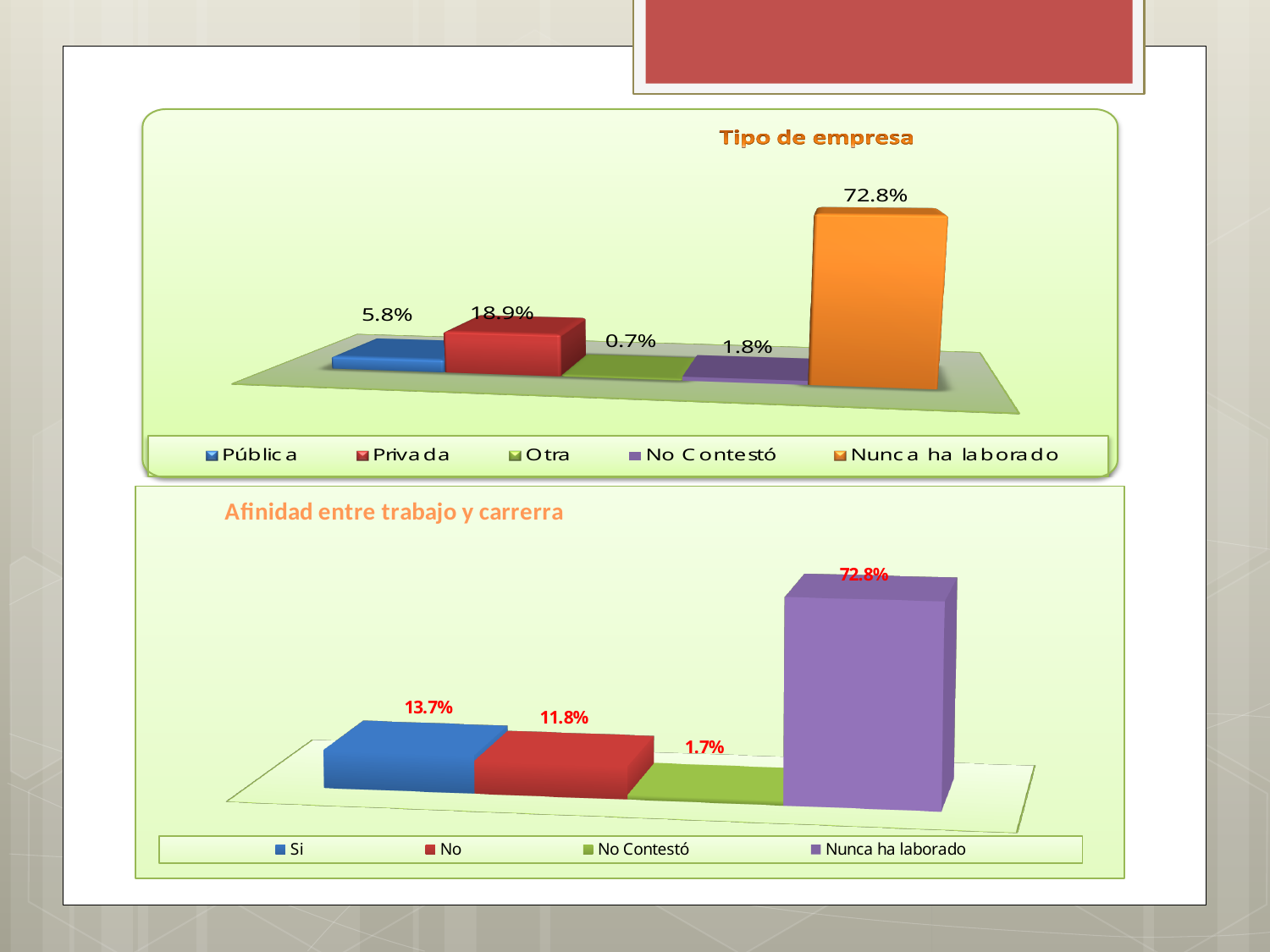
In the 'Tipo de empresa' chart, what is the value for Privada? 18.9% In the 'Afinidad entre trabajo y carrerra' chart, which is larger, Si or No? Si In the 'Afinidad entre trabajo y carrerra' chart, what is the difference between Si and No? 1.9% In the 'Afinidad entre trabajo y carrerra' chart, what colour is the bar for Nunca ha laborado? Purple In the 'Tipo de empresa' chart, what is the difference between Nunca ha laborado and Privada? 53.9% In the 'Afinidad entre trabajo y carrerra' chart, what is the value for No Contestó? 1.7% What kind of chart is the 'Afinidad entre trabajo y carrerra' chart? Bar chart In the 'Afinidad entre trabajo y carrerra' chart, what is the value for Si? 13.7% In the 'Tipo de empresa' chart, how many categories are shown in the legend? 5 In the 'Tipo de empresa' chart, which category has the lowest value? Otra In the 'Tipo de empresa' chart, which category has the highest value? Nunca ha laborado In the 'Tipo de empresa' chart, what is the value for Pública? 5.8%